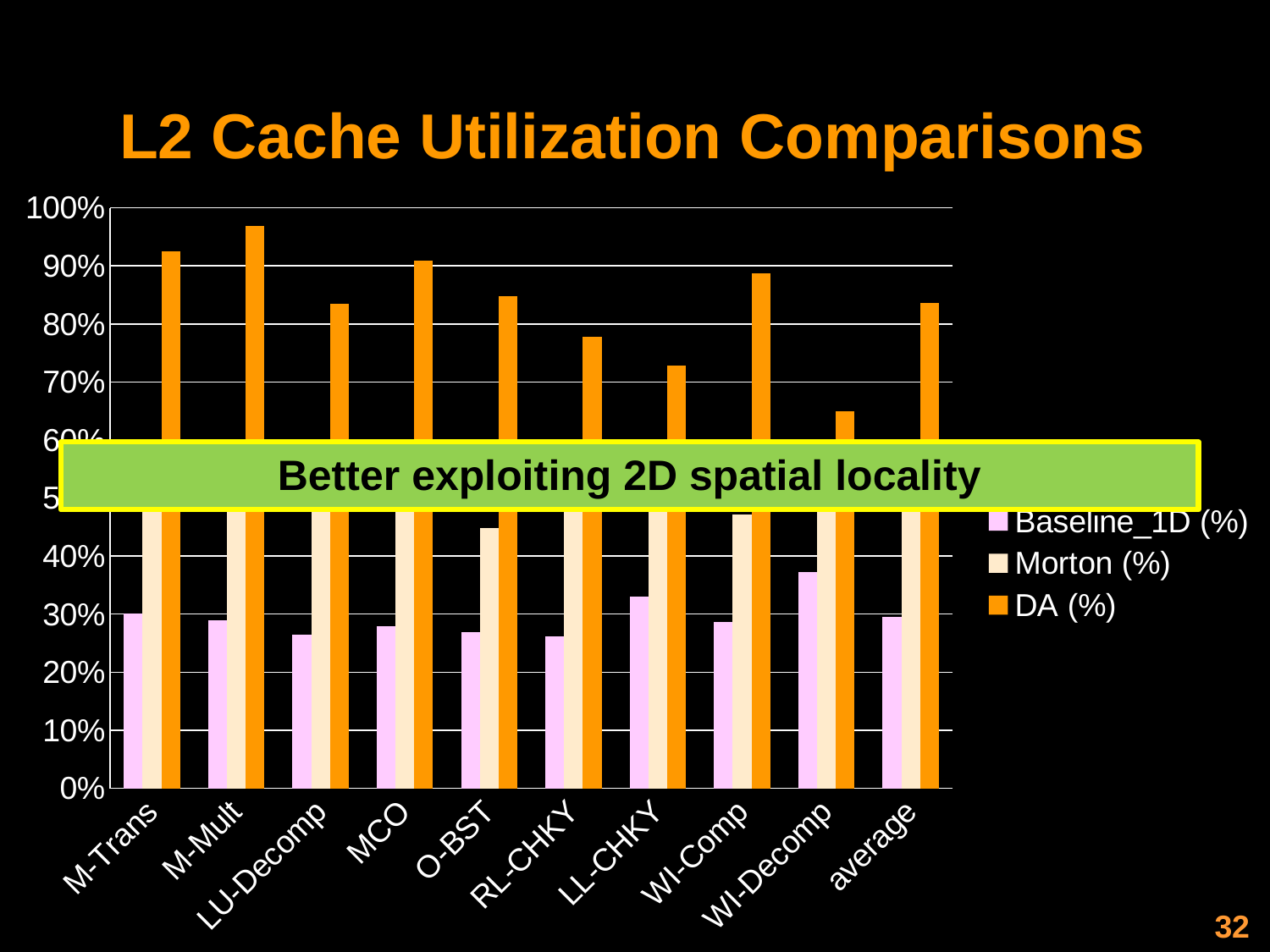
Which is larger, the DA (%) value for M-Trans or for LU-Decomp? M-Trans Is the DA (%) value for LL-CHKY greater or less than 80%? less Is the DA (%) value for WI-Decomp greater or less than 70%? less What kind of chart is shown on the slide? bar chart Which category has the highest Baseline_1D (%) value? WI-Decomp What is the title of the chart? L2 Cache Utilization Comparisons Is the DA (%) value for M-Mult greater or less than 90%? greater Which category has the lowest DA (%) value? WI-Decomp Which category has the highest DA (%) value? M-Mult How many series does the legend list? 3 How many categories are shown along the x axis? 10